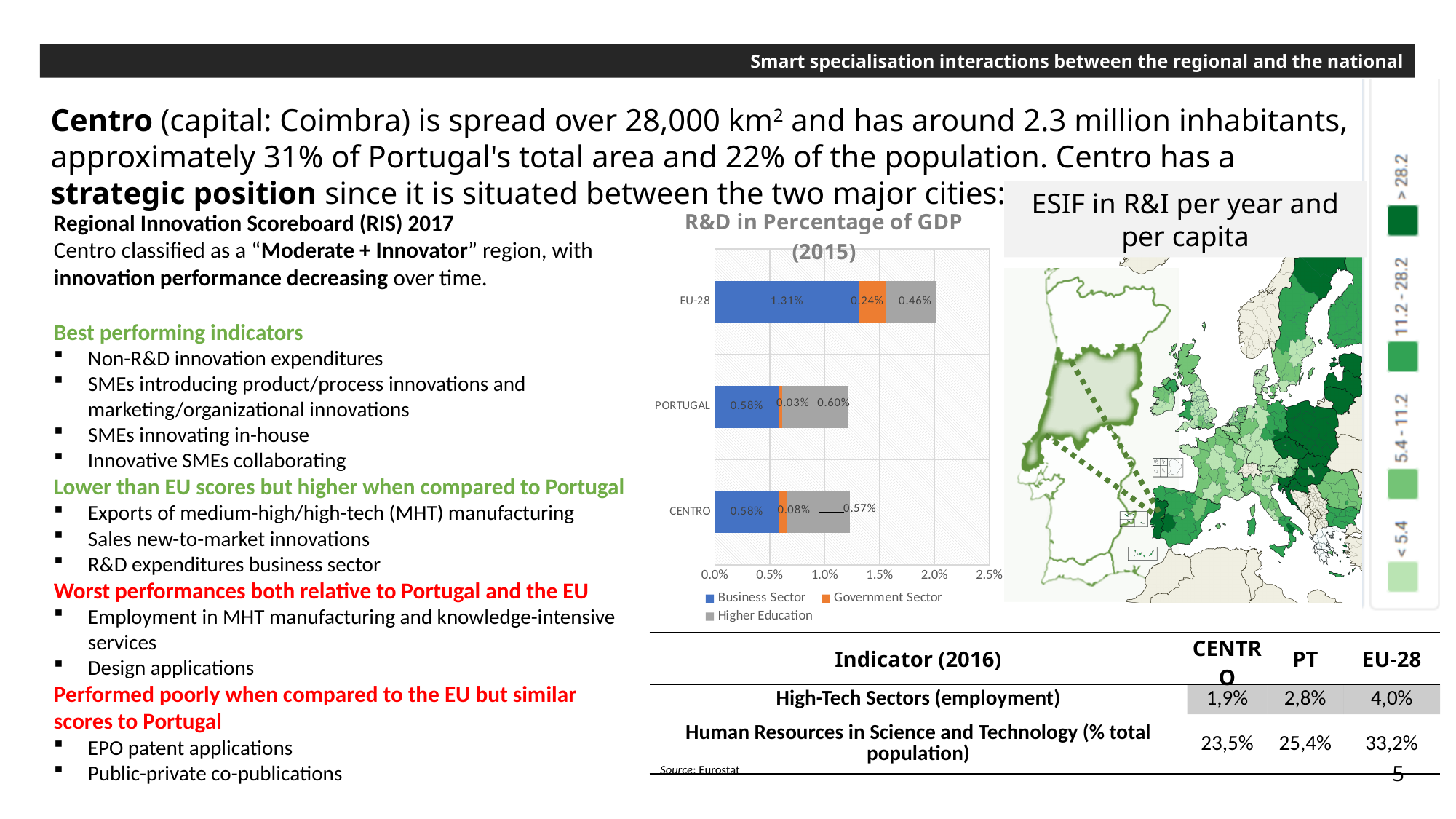
In the "R&D in Percentage of GDP (2015)" chart, what is the Government Sector value for PORTUGAL? 0.03% How many regions are shown on the "R&D in Percentage of GDP (2015)" chart? 3 In the "R&D in Percentage of GDP (2015)" chart, what is the Business Sector value for EU-28? 1.31% What type of chart is "R&D in Percentage of GDP (2015)"? Stacked bar chart In the "R&D in Percentage of GDP (2015)" chart, what is the total of the stacked bar for EU-28? 2.01% In the "R&D in Percentage of GDP (2015)" chart, what is the Higher Education value for PORTUGAL? 0.60% In the "R&D in Percentage of GDP (2015)" chart, what is the Government Sector value for CENTRO? 0.08% In the "R&D in Percentage of GDP (2015)" chart, is the Higher Education value for EU-28 larger or smaller than the Higher Education value for CENTRO? Smaller How many series does the legend of the "R&D in Percentage of GDP (2015)" chart list? 3 In the "R&D in Percentage of GDP (2015)" chart, what is the difference between the Business Sector values for EU-28 and CENTRO? 0.73% In the "R&D in Percentage of GDP (2015)" chart, which region has the highest Business Sector value? EU-28 In the "R&D in Percentage of GDP (2015)" chart, which region has the lowest Government Sector value? PORTUGAL